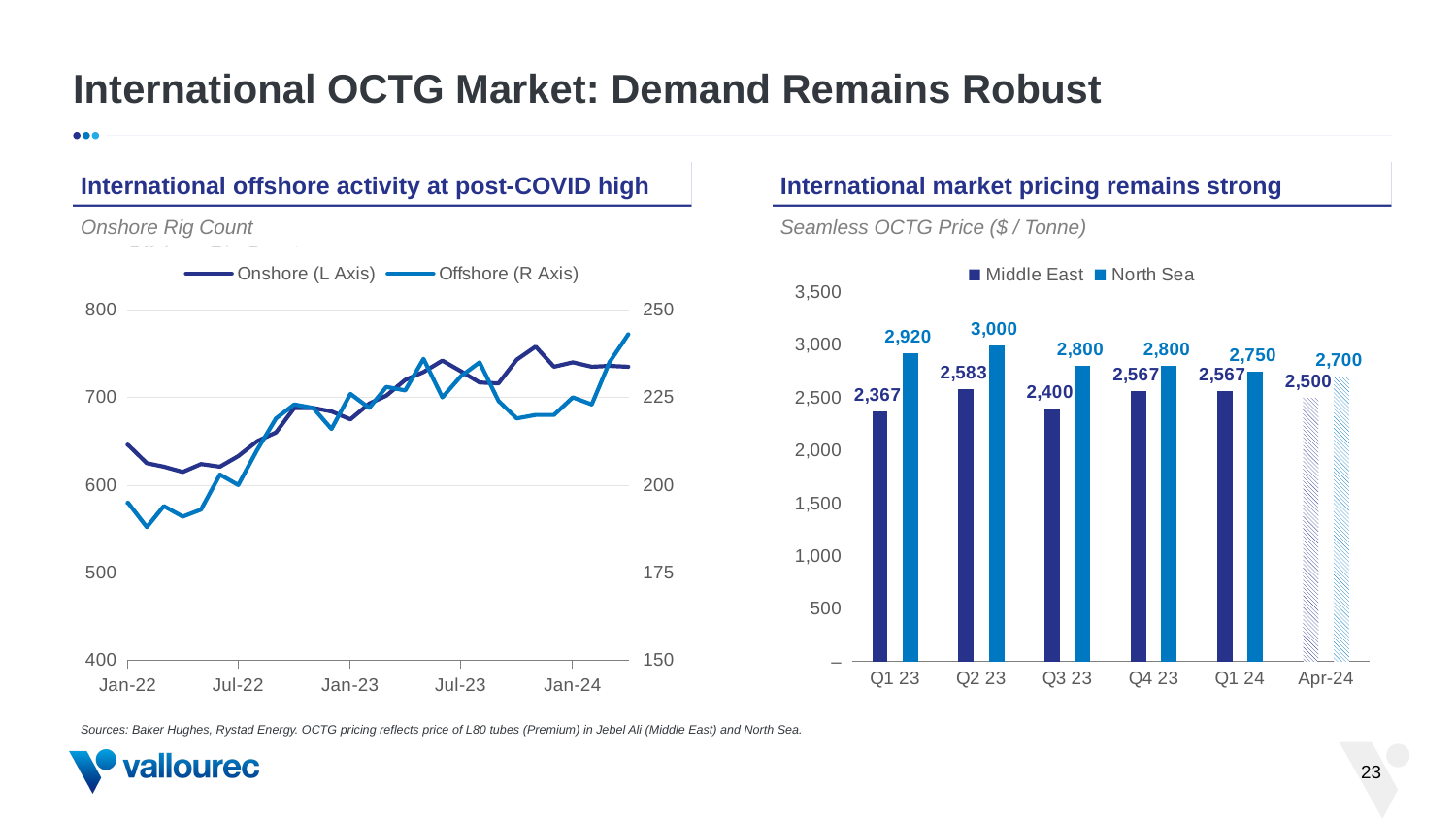
In the 'International market pricing remains strong' chart, which period has the highest North Sea price? Q2 23 In the 'International market pricing remains strong' chart, which is larger in Q1 24: the Middle East price or the North Sea price? North Sea What kind of chart is the 'International offshore activity at post-COVID high' chart? Line chart In the 'International market pricing remains strong' chart, how many series does the legend list? 2 In the 'International market pricing remains strong' chart, what is the Middle East price for Q1 23? 2,367 In the 'International market pricing remains strong' chart, what is the North Sea price for Apr-24? 2,700 In the 'International market pricing remains strong' chart, which period has the lowest Middle East price? Q1 23 In the 'International offshore activity at post-COVID high' chart, does the Offshore series generally rise or fall from Jan-22 to Jan-24? Rise In the 'International market pricing remains strong' chart, how many periods are shown on the x axis? 6 In the 'International market pricing remains strong' chart, what is the North Sea price for Q2 23? 3,000 In the 'International offshore activity at post-COVID high' chart, is the Onshore value at Jan-22 greater or less than 600? greater In the 'International market pricing remains strong' chart, what is the difference between the North Sea and Middle East prices in Q3 23? 400